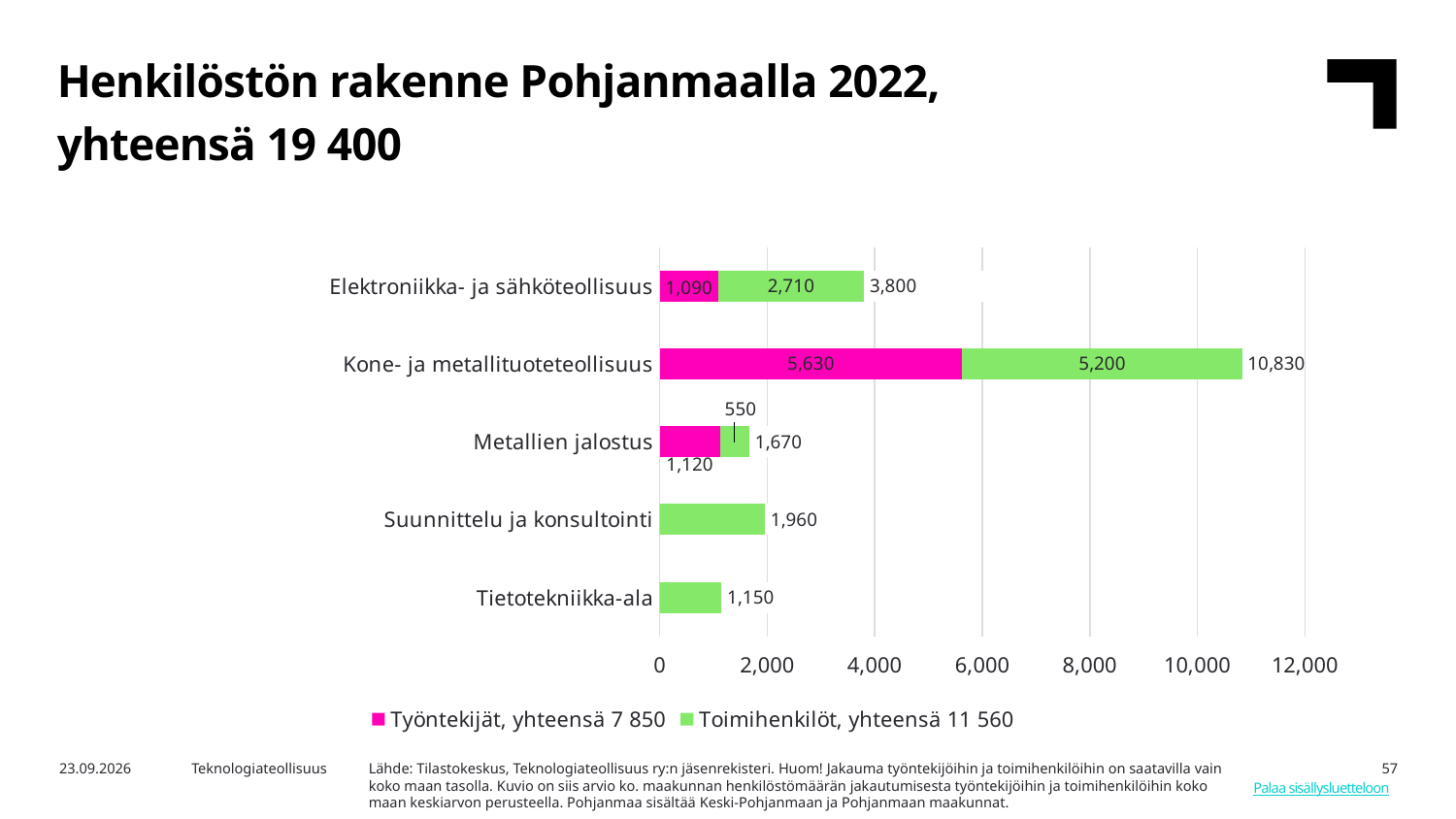
What is the Työntekijät value for Kone- ja metallituoteteollisuus? 5,630 What is the total for Työntekijät given in the legend? 7 850 How many categories are shown on the chart? 5 How many series does the legend list? 2 What is the total for Metallien jalostus? 1,670 What is the Toimihenkilöt value for Elektroniikka- ja sähköteollisuus? 2,710 Which category has the lowest total? Tietotekniikka-ala What type of chart is shown on the slide? Stacked bar chart Which is larger: the total for Suunnittelu ja konsultointi or the total for Tietotekniikka-ala? Suunnittelu ja konsultointi Is the total for Elektroniikka- ja sähköteollisuus greater or less than 4,000? less Which category has the highest total? Kone- ja metallituoteteollisuus What is the difference between the Työntekijät and Toimihenkilöt values for Kone- ja metallituoteteollisuus? 430